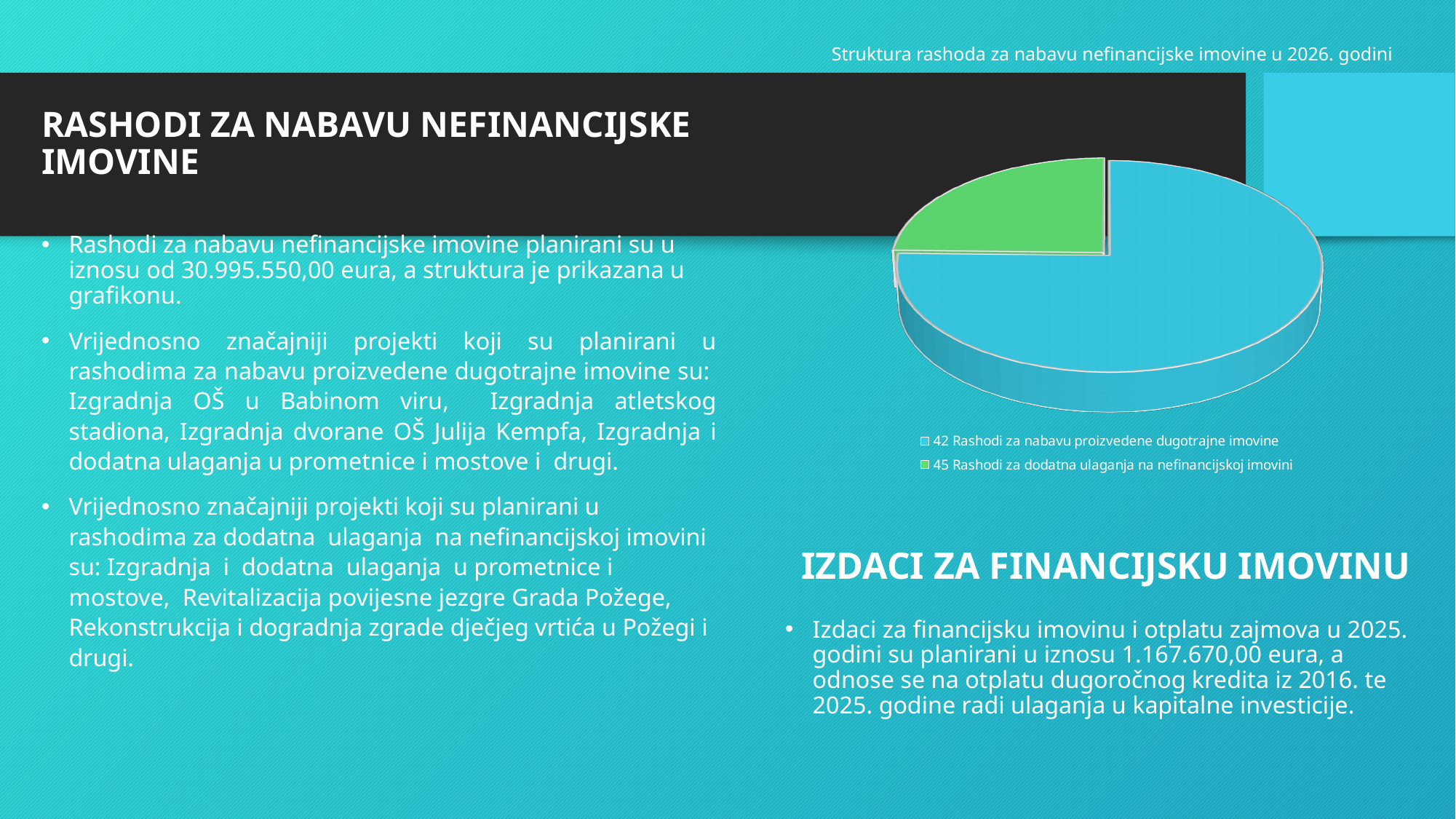
Which is larger in the pie chart: 42 Rashodi za nabavu proizvedene dugotrajne imovine or 45 Rashodi za dodatna ulaganja na nefinancijskoj imovini? 42 Rashodi za nabavu proizvedene dugotrajne imovine What kind of chart is shown on the slide? pie chart What colour is the slice for 45 Rashodi za dodatna ulaganja na nefinancijskoj imovini? green What is the title of the chart on the slide? Struktura rashoda za nabavu nefinancijske imovine u 2026. godini How many slices does the pie chart have? 2 How many entries does the chart legend list? 2 Which category has the smallest slice of the pie chart? 45 Rashodi za dodatna ulaganja na nefinancijskoj imovini Which category has the largest slice of the pie chart? 42 Rashodi za nabavu proizvedene dugotrajne imovine